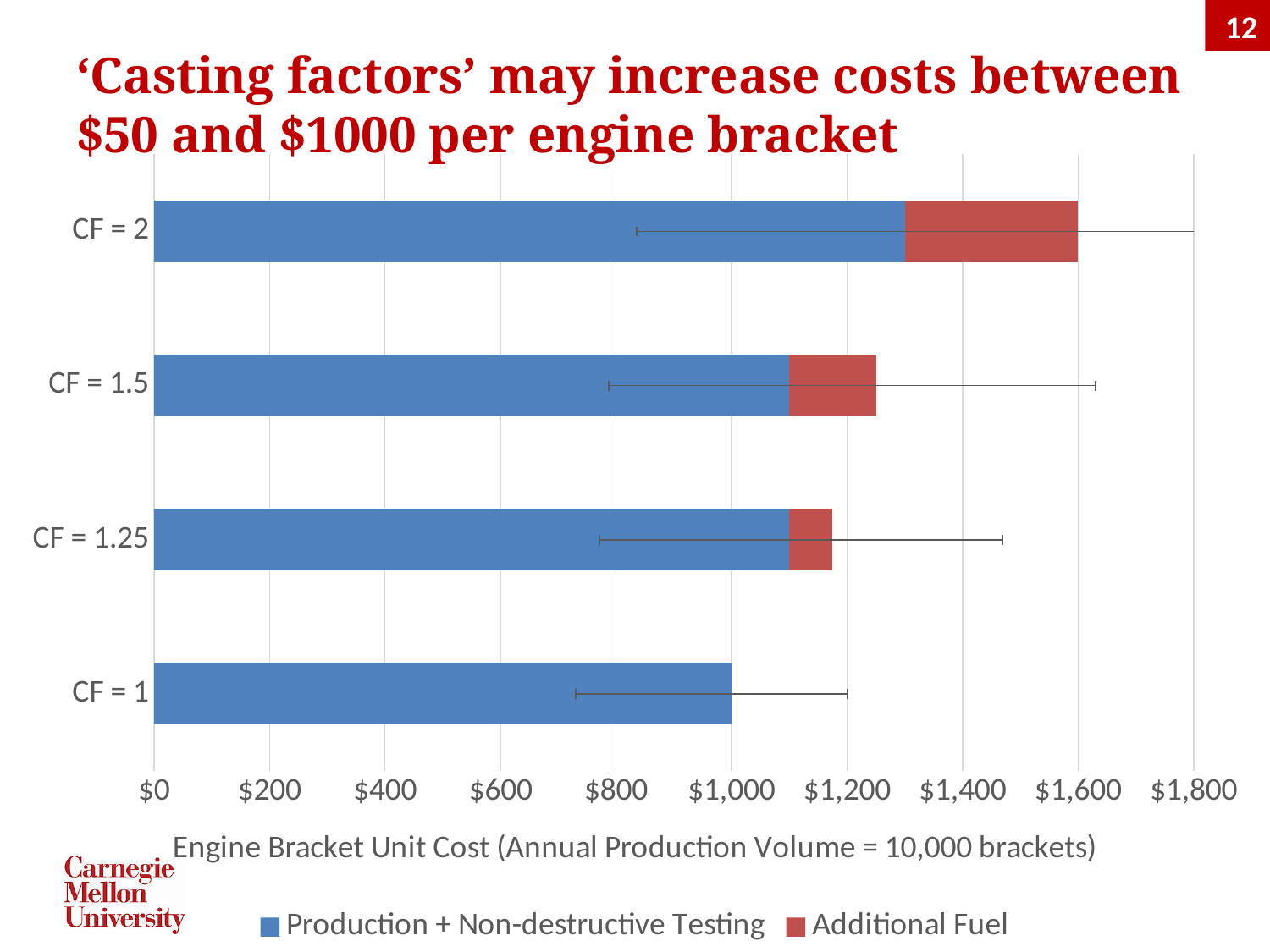
Which has a larger Additional Fuel cost, CF = 1.5 or CF = 2? CF = 2 What is the Production + Non-destructive Testing cost for CF = 1? $1,000 Is the total unit cost for CF = 2 greater or less than $1,400? greater What is the title of the horizontal axis of the chart? Engine Bracket Unit Cost (Annual Production Volume = 10,000 brackets) Is the Production + Non-destructive Testing cost for CF = 2 greater or less than $1,200? greater As the casting factor increases from CF = 1 to CF = 2, does the total unit cost rise or fall? rise Which CF category has the lowest total engine bracket unit cost? CF = 1 Is the total unit cost for CF = 1.25 greater or less than $1,400? less How many casting factor (CF) categories are plotted on the chart? 4 How many series does the legend list? 2 What kind of chart is shown on the slide? Stacked bar chart Which CF category has the highest total engine bracket unit cost? CF = 2